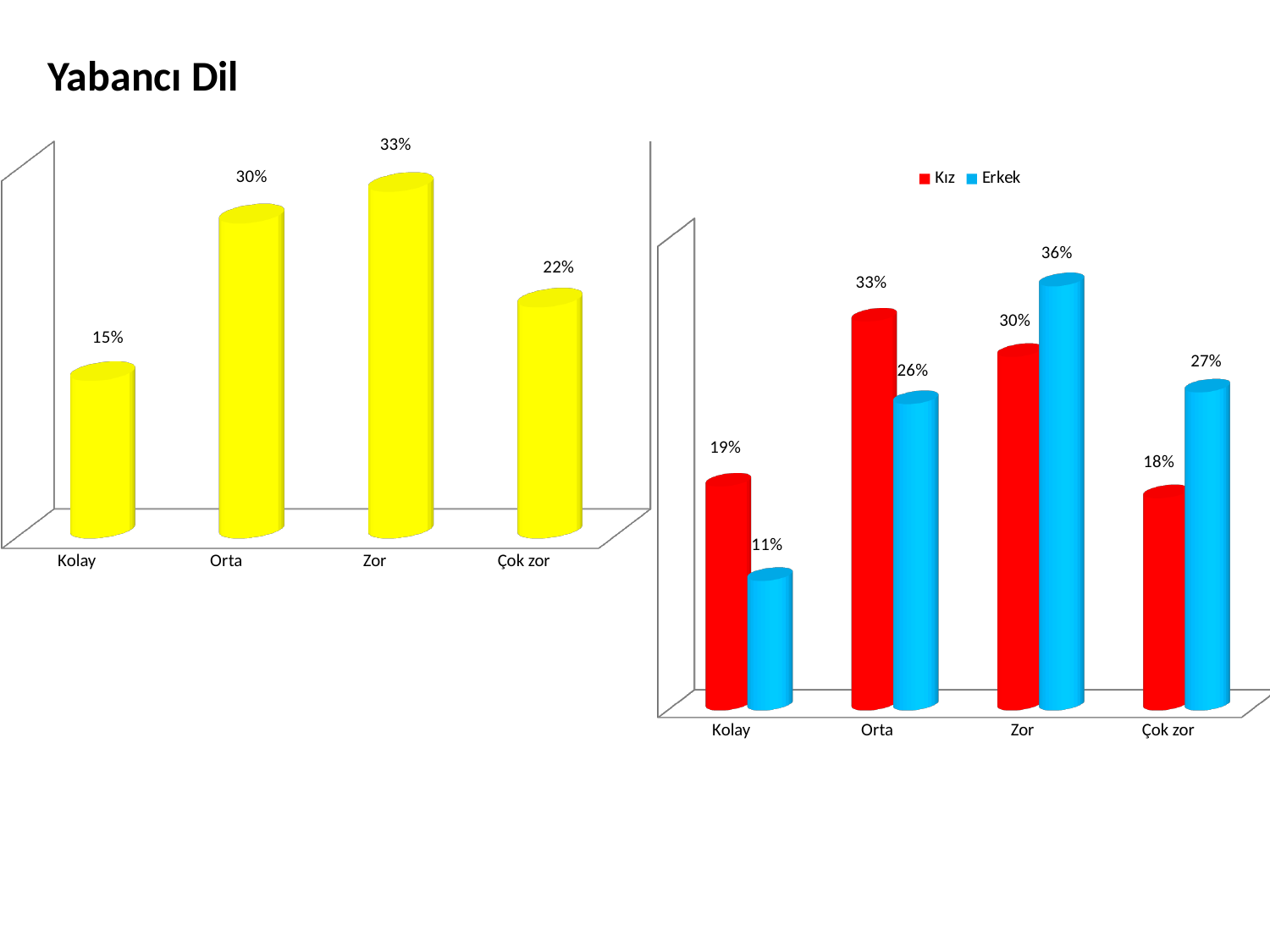
In the left chart, what is the difference between the values for Zor and Çok zor? 11% In the left chart, which category has the highest value? Zor In the right chart, what is the Erkek value for Kolay? 11% In the left chart, which category has the lowest value? Kolay How many categories are shown in the left chart? 4 In the left chart, what is the value for Orta? 30% In the right chart, what is the Kız value for Orta? 33% In the right chart, which category has the highest Erkek value? Zor How many series does the legend of the right chart list? 2 In the right chart, which is larger for Çok zor: Kız or Erkek? Erkek In the right chart, what is the difference between the Kız and Erkek values for Kolay? 8% What type of chart is the left chart? Bar chart